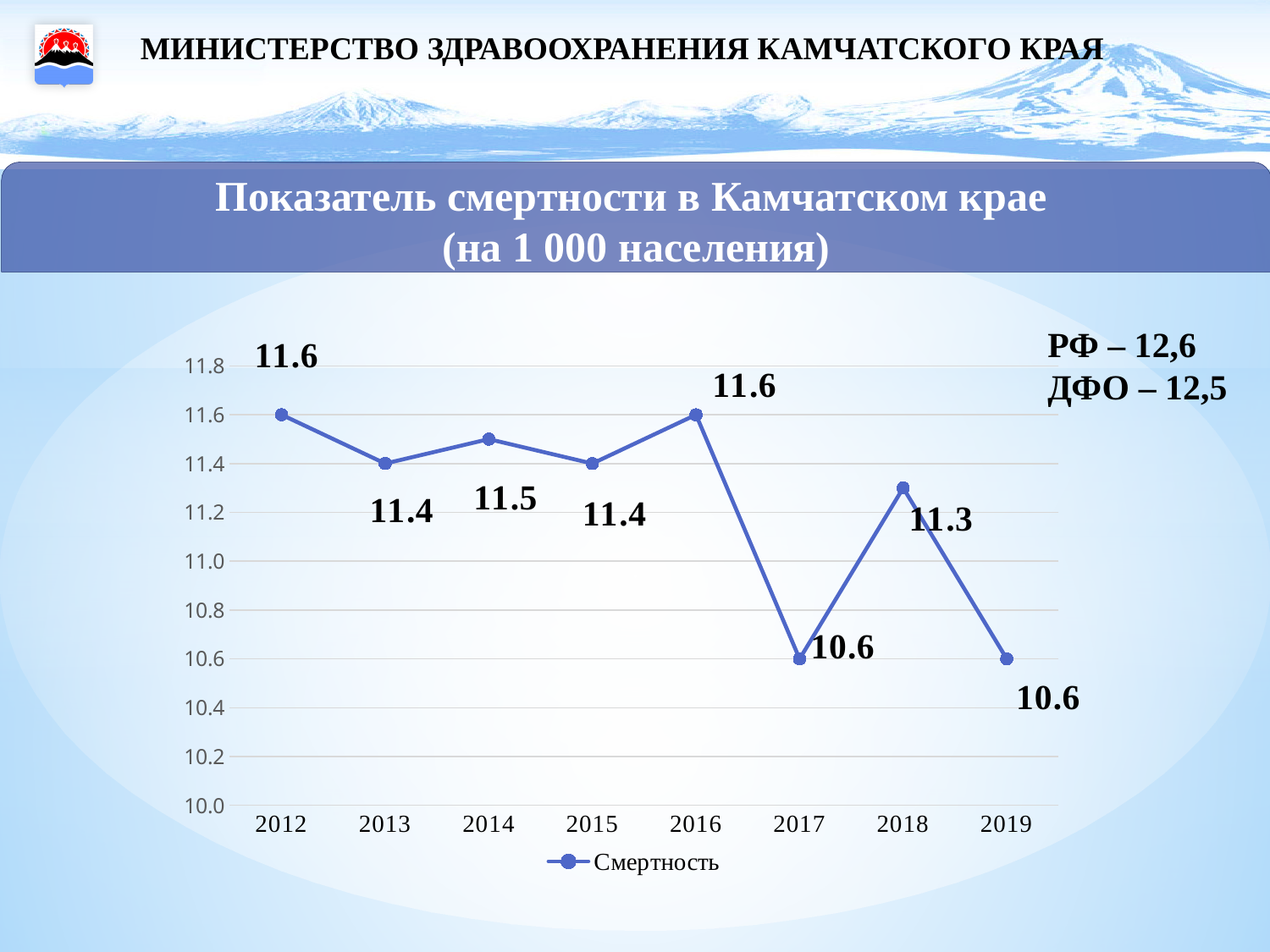
Is the mortality rate for 2019 greater or less than 11.0? less What is the difference between the mortality rate in 2018 and in 2019? 0.7 How many years are plotted on the x axis? 8 What is the difference between the mortality rate in 2016 and in 2017? 1.0 What kind of chart is shown on the slide? line chart What is the mortality rate (Смертность) for 2012? 11.6 Does the mortality rate rise or fall from 2016 to 2017? fall What is the mortality rate (Смертность) for 2014? 11.5 Is the mortality rate for 2015 greater or less than 11.0? greater What is the mortality rate (Смертность) for 2018? 11.3 How many series does the legend list? 1 Which year has the lowest mortality rate, 2013 or 2017? 2017